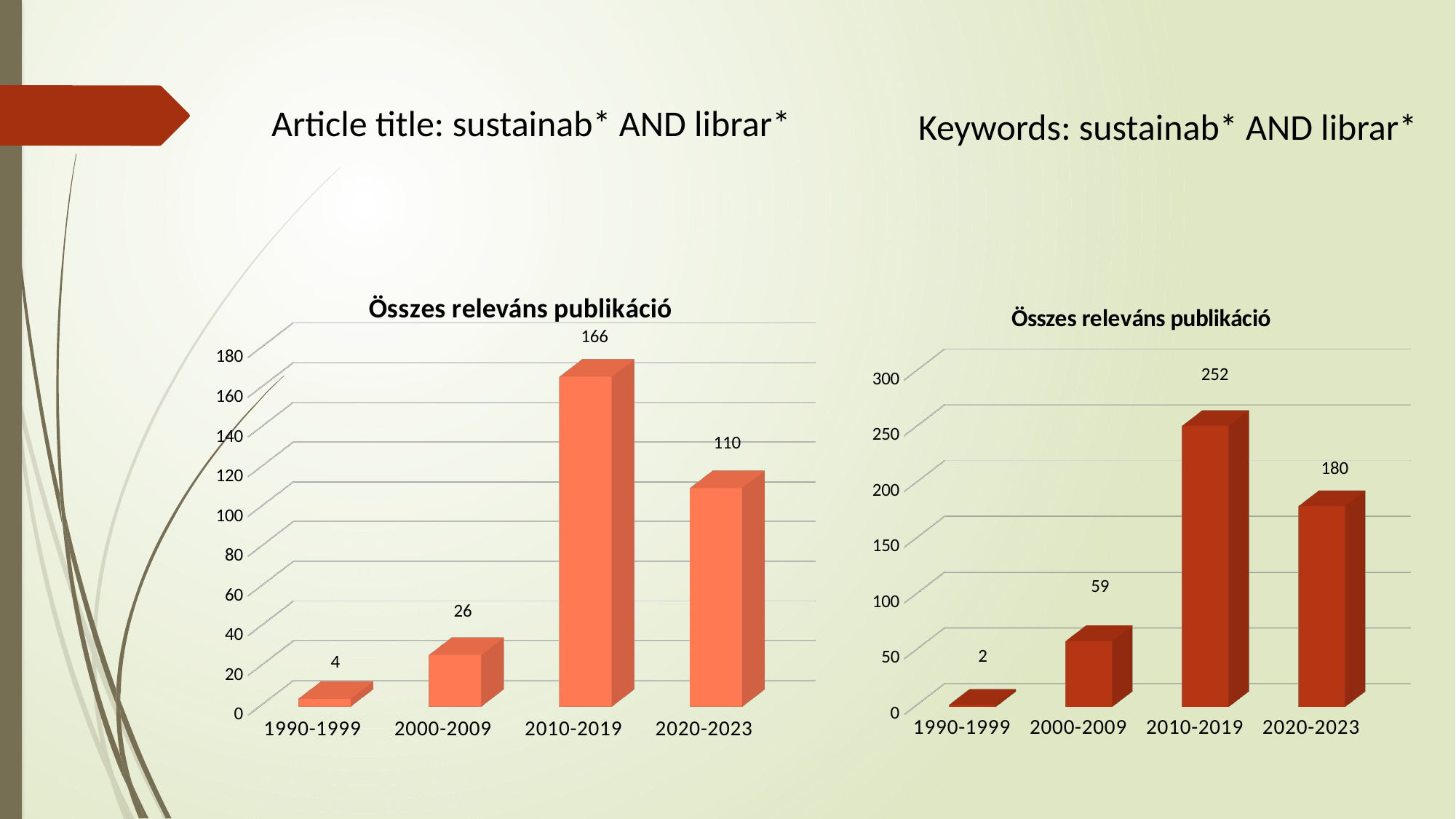
In the right chart (Keywords: sustainab* AND librar*), is the value for 2010-2019 greater or less than 250? greater In the left chart (Article title: sustainab* AND librar*), what is the difference between the values for 2010-2019 and 2020-2023? 56 In the left chart (Article title: sustainab* AND librar*), which period has the lowest value? 1990-1999 In the right chart (Keywords: sustainab* AND librar*), what is the difference between the values for 2010-2019 and 2020-2023? 72 What is the title of the right chart (Keywords: sustainab* AND librar*)? Összes releváns publikáció What kind of chart is the right chart (Keywords: sustainab* AND librar*)? Bar chart In the left chart (Article title: sustainab* AND librar*), what is the value for 2010-2019? 166 How many periods are shown on the x axis of the left chart (Article title: sustainab* AND librar*)? 4 Which is larger: the value for 2020-2023 in the left chart or the value for 2020-2023 in the right chart? The right chart (180) In the left chart (Article title: sustainab* AND librar*), do the values rise or fall from 1990-1999 to 2010-2019? Rise In the right chart (Keywords: sustainab* AND librar*), what is the value for 2000-2009? 59 In the right chart (Keywords: sustainab* AND librar*), which period has the highest value? 2010-2019